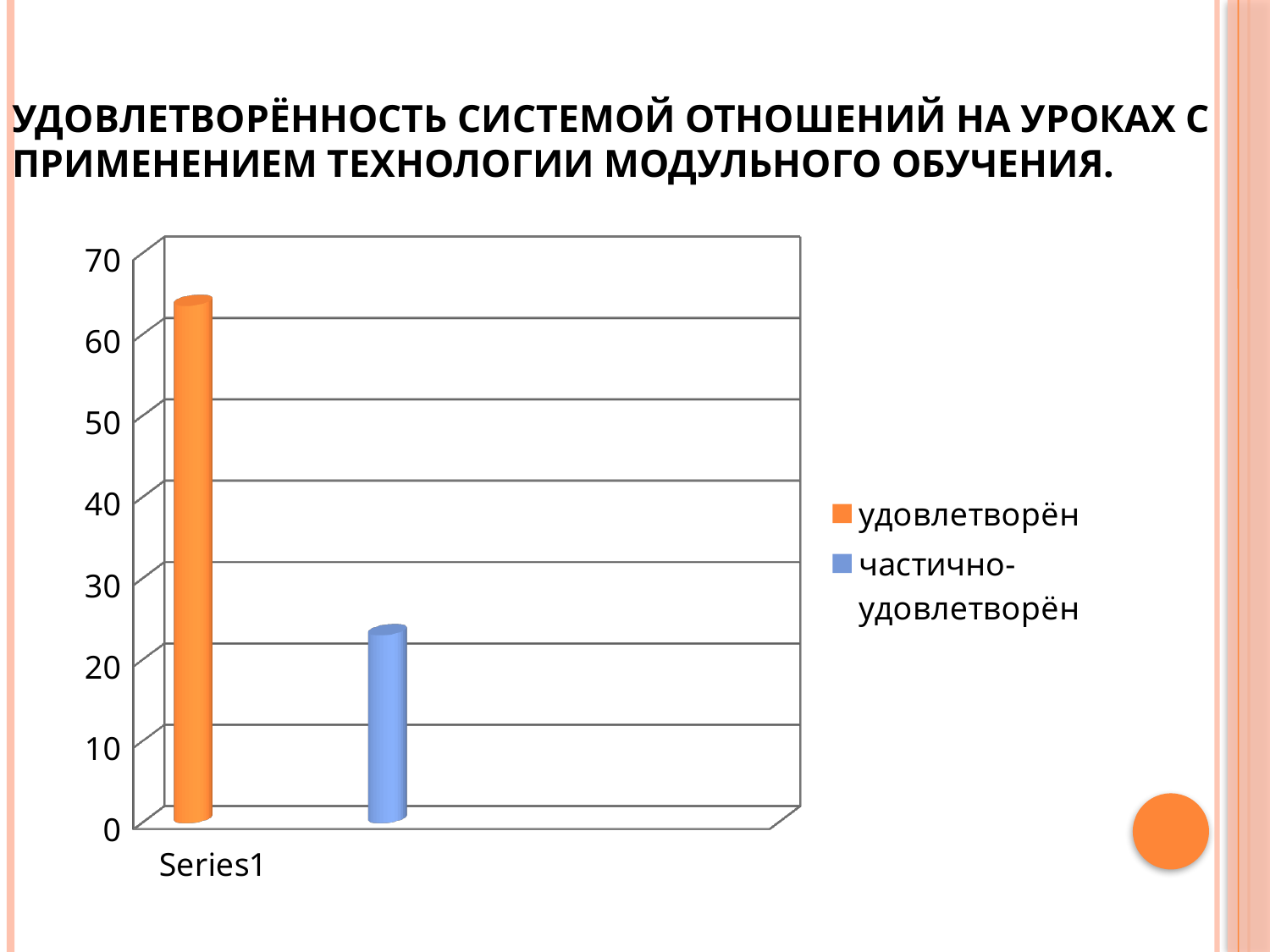
Is the value for частично-удовлетворён greater or less than 20? greater Which series has the lowest value? частично-удовлетворён Is the value for частично-удовлетворён greater or less than 30? less Which is larger, the value for удовлетворён or the value for частично-удовлетворён? удовлетворён What kind of chart is shown on the slide? bar chart How many categories are shown on the x axis? 1 What colour is the bar for удовлетворён? orange How many series does the legend list? 2 What is the label on the x axis under the bars? Series1 Which series has the highest value? удовлетворён Is the value for удовлетворён greater or less than 60? greater